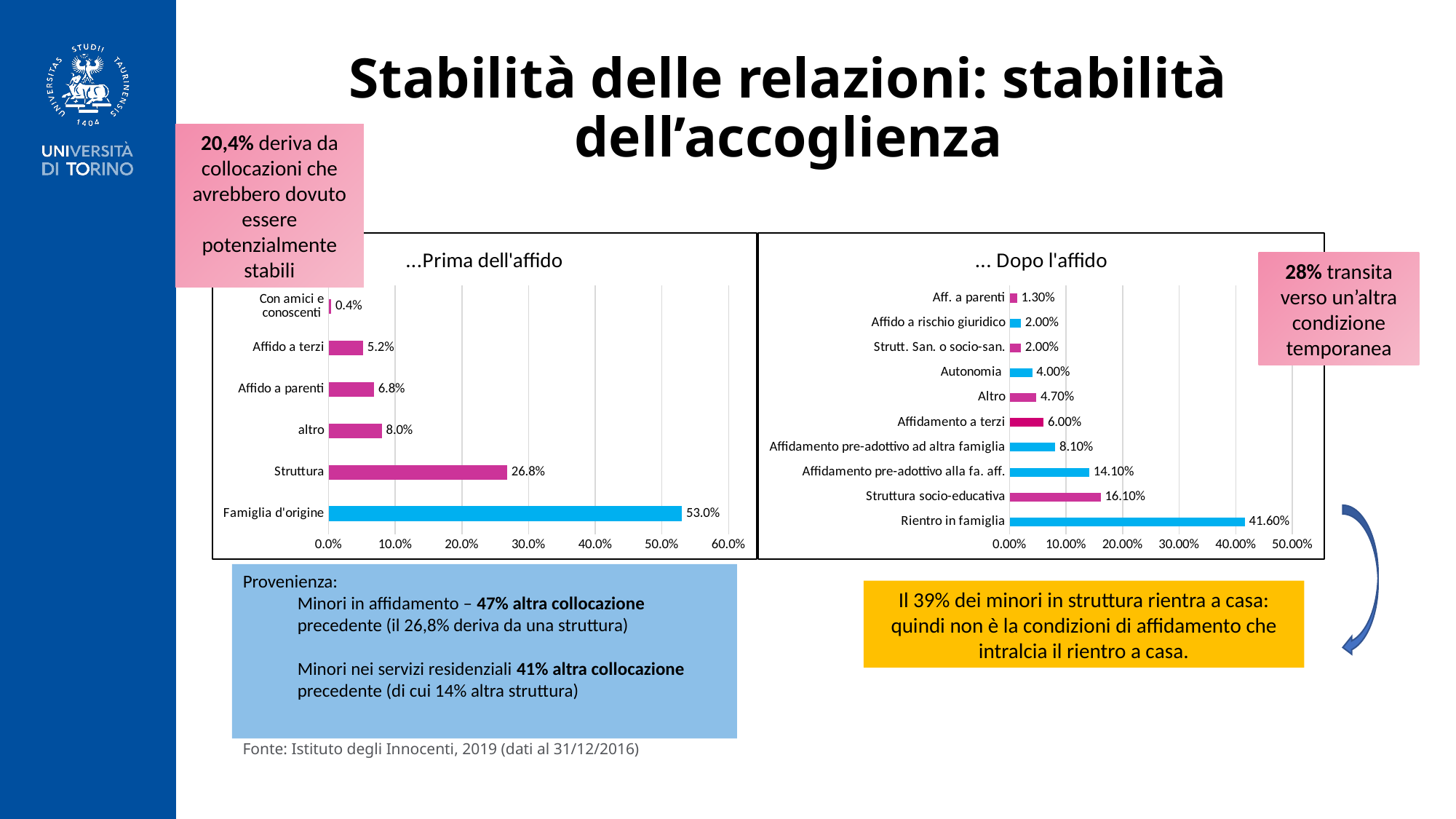
In the "...Prima dell'affido" chart, which category has the highest value? Famiglia d'origine In the "... Dopo l'affido" chart, what is the value for Struttura socio-educativa? 16.10% In the "...Prima dell'affido" chart, how many categories are shown? 6 In the "...Prima dell'affido" chart, is the value for Affido a parenti greater or less than 10.0%? less What type of chart is the "... Dopo l'affido" chart? Bar chart In the "... Dopo l'affido" chart, which category has the lowest value? Aff. a parenti In the "...Prima dell'affido" chart, which category has the lowest value? Con amici e conoscenti In the "... Dopo l'affido" chart, which is larger: Affidamento pre-adottivo alla fa. aff. or Affidamento pre-adottivo ad altra famiglia? Affidamento pre-adottivo alla fa. aff. In the "... Dopo l'affido" chart, how many categories are shown? 10 In the "... Dopo l'affido" chart, which category has the highest value? Rientro in famiglia In the "...Prima dell'affido" chart, what is the difference between Famiglia d'origine and Struttura? 26.2% In the "...Prima dell'affido" chart, what is the value for Struttura? 26.8%